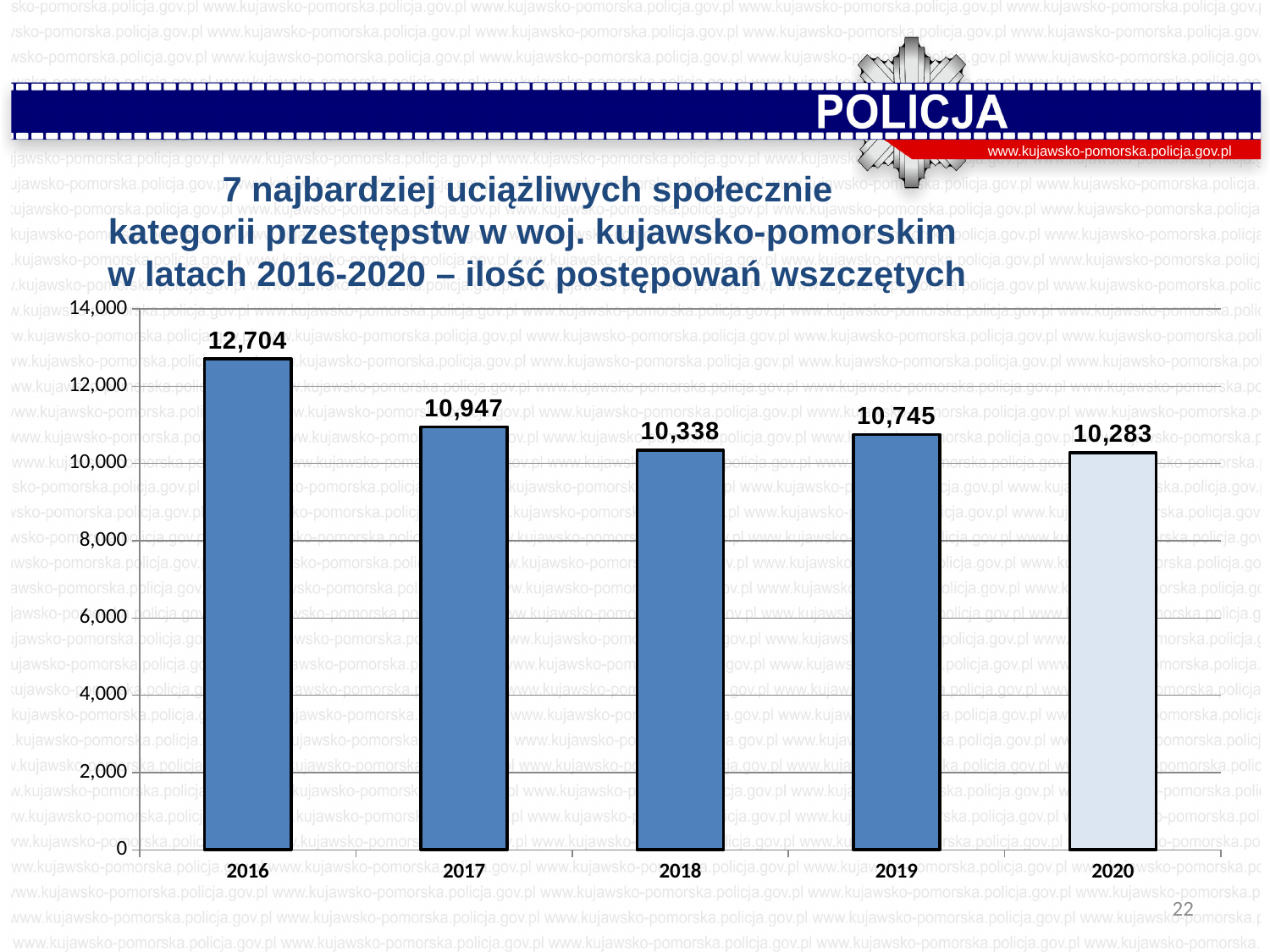
What is the value for 2020? 10,283 What is the difference between the values for 2016 and 2017? 1,757 What kind of chart is shown on the slide? bar chart How many years are shown on the x axis? 5 Which bar is shown in a lighter colour than the others? 2020 Is the value for 2018 greater or less than 12,000? less What is the value for 2018? 10,338 What is the value for 2016? 12,704 Which year has the highest value? 2016 Which year has the lowest value? 2020 What is the difference between the values for 2019 and 2020? 462 Which is larger, the value for 2017 or the value for 2019? 2017